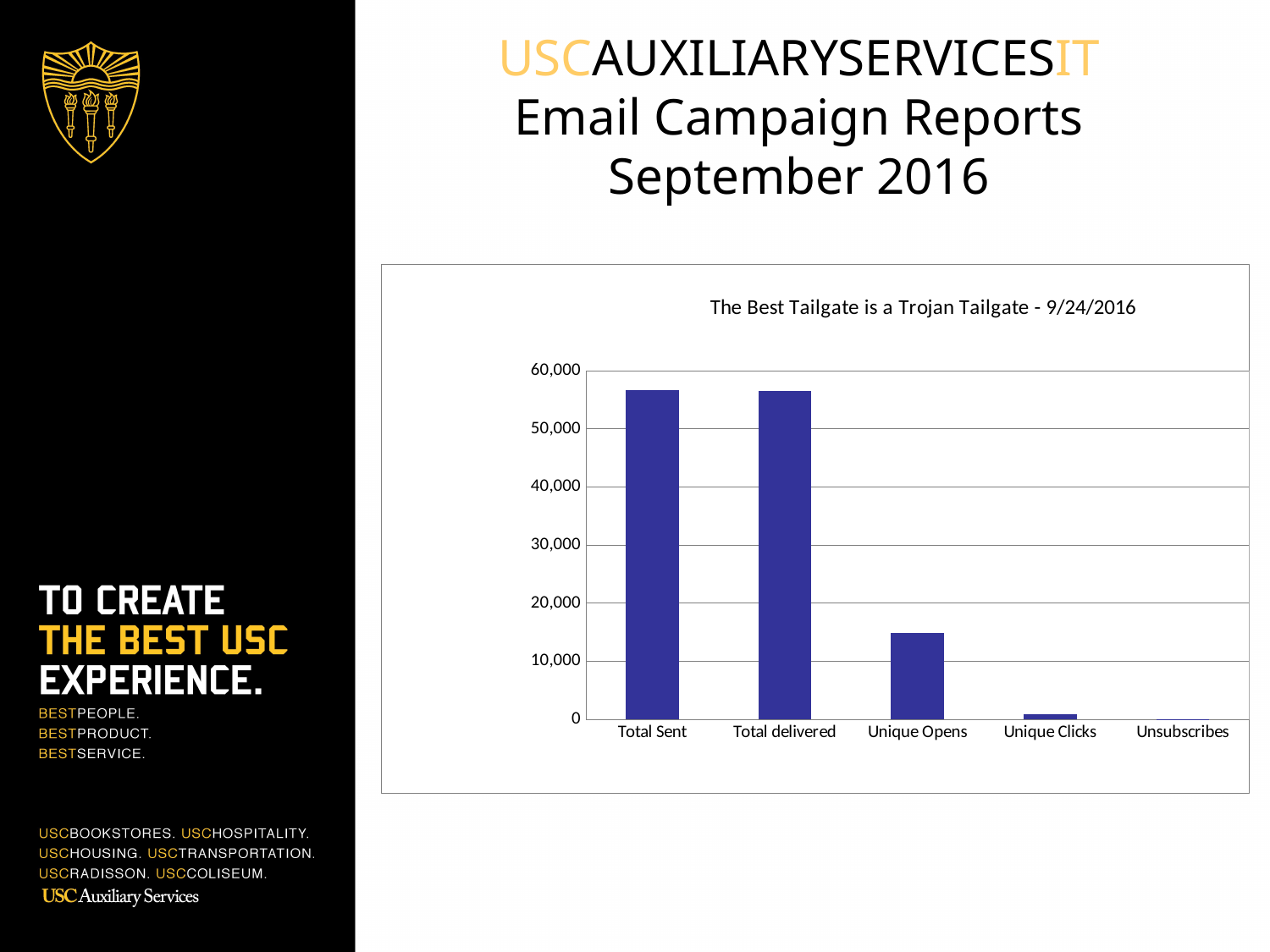
Is the value for Unique Opens greater or less than 10,000? greater Which category has the lowest value in the chart? Unsubscribes What kind of chart is shown on the slide? bar chart Which is larger, the value for Unique Clicks or the value for Unique Opens? Unique Opens What is the title of the chart? The Best Tailgate is a Trojan Tailgate - 9/24/2016 Which is larger, the value for Total Sent or the value for Unique Opens? Total Sent Is the value for Total delivered greater or less than 60,000? less How many categories are shown on the x axis of the chart? 5 Do the values rise or fall moving from left to right along the x axis? fall Is the value for Total Sent greater or less than 50,000? greater